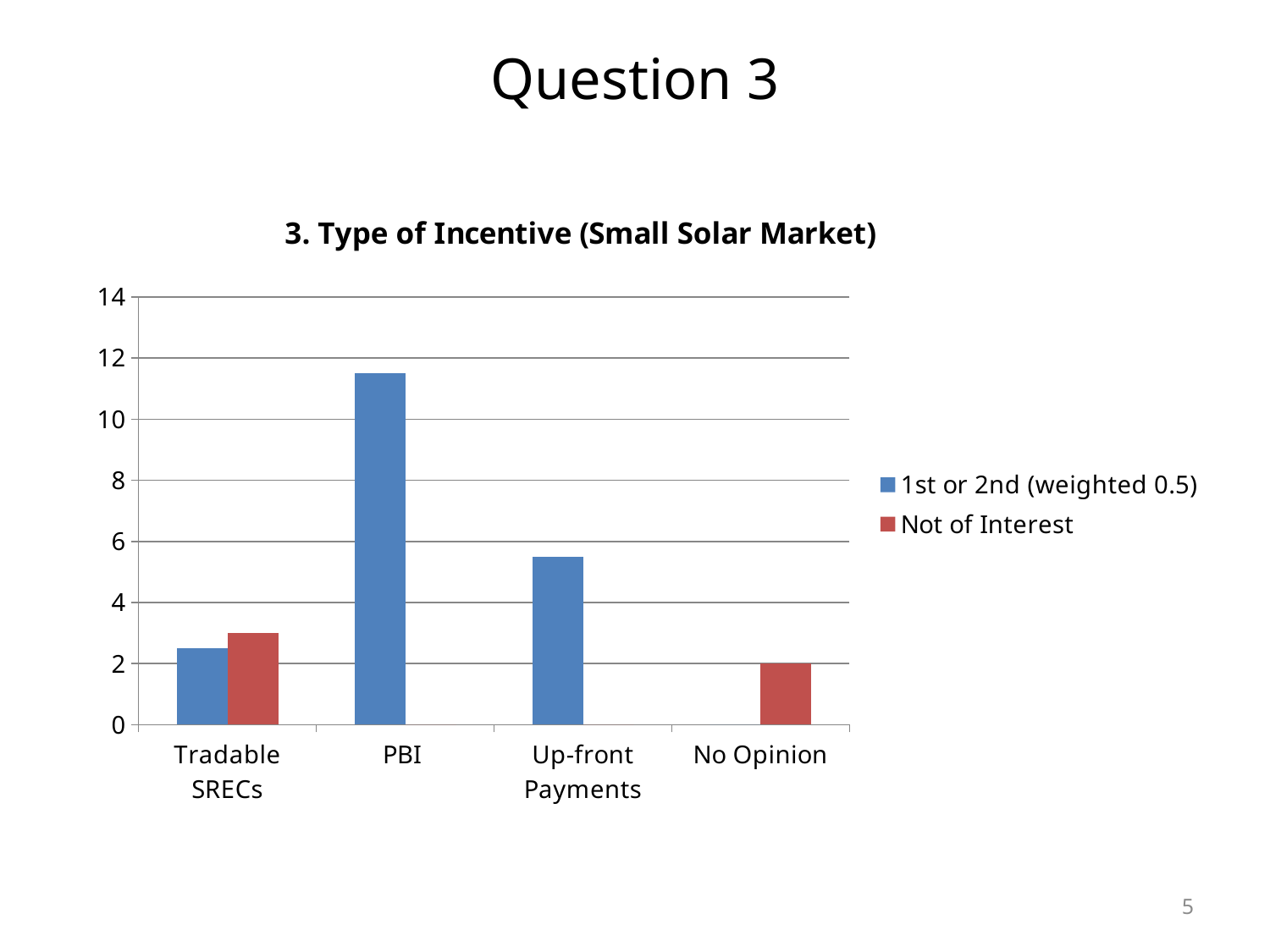
What is the title of the chart? 3. Type of Incentive (Small Solar Market) Is the value for Tradable SRECs in the 1st or 2nd (weighted 0.5) series greater or less than 4? less What is the value for No Opinion in the Not of Interest series? 2 Is the value for Up-front Payments in the 1st or 2nd (weighted 0.5) series greater or less than 4? greater Which colour represents the Not of Interest series? red Is the value for Tradable SRECs in the Not of Interest series greater or less than 4? less How many series does the legend list? 2 Which category has the highest value in the 1st or 2nd (weighted 0.5) series? PBI How many categories are shown on the x axis? 4 What type of chart is shown on the slide? bar chart Which is larger in the 1st or 2nd (weighted 0.5) series: PBI or Up-front Payments? PBI